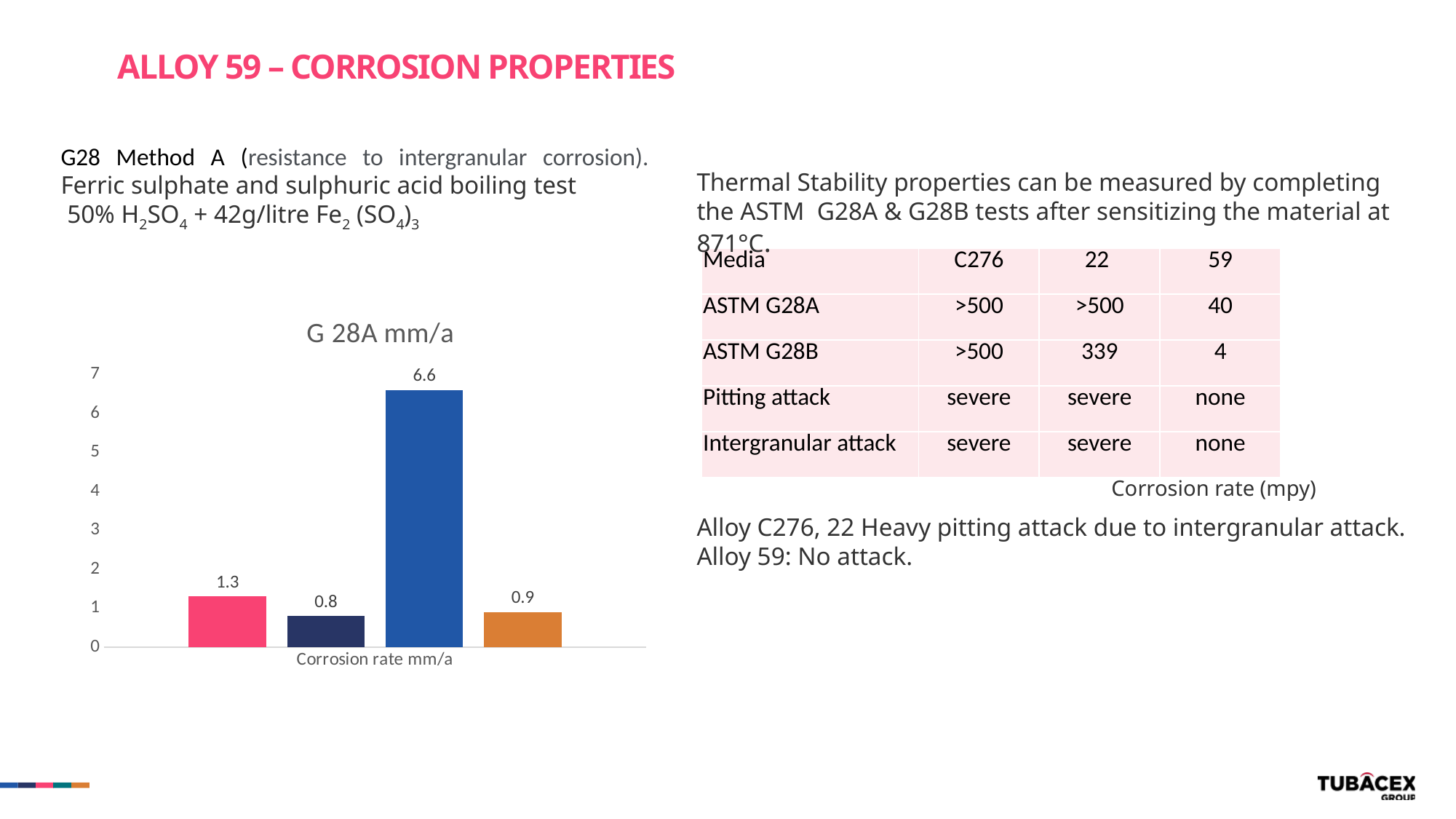
What is the difference between the tallest bar and the shortest bar? 5.8 What is the value of the tallest bar in the chart? 6.6 What is the label shown on the x axis of the chart? Corrosion rate mm/a What is the value of the shortest bar in the chart? 0.8 What is the title of the chart? G 28A mm/a What is the value of the first (pink) bar from the left? 1.3 Is the value of the third (blue) bar greater or less than 6? greater What kind of chart is shown on the slide? bar chart What is the value of the third (blue) bar from the left? 6.6 How many bars are plotted in the chart? 4 Which is larger, the first (pink) bar or the fourth (orange) bar? the first (pink) bar What is the value of the fourth (orange) bar from the left? 0.9